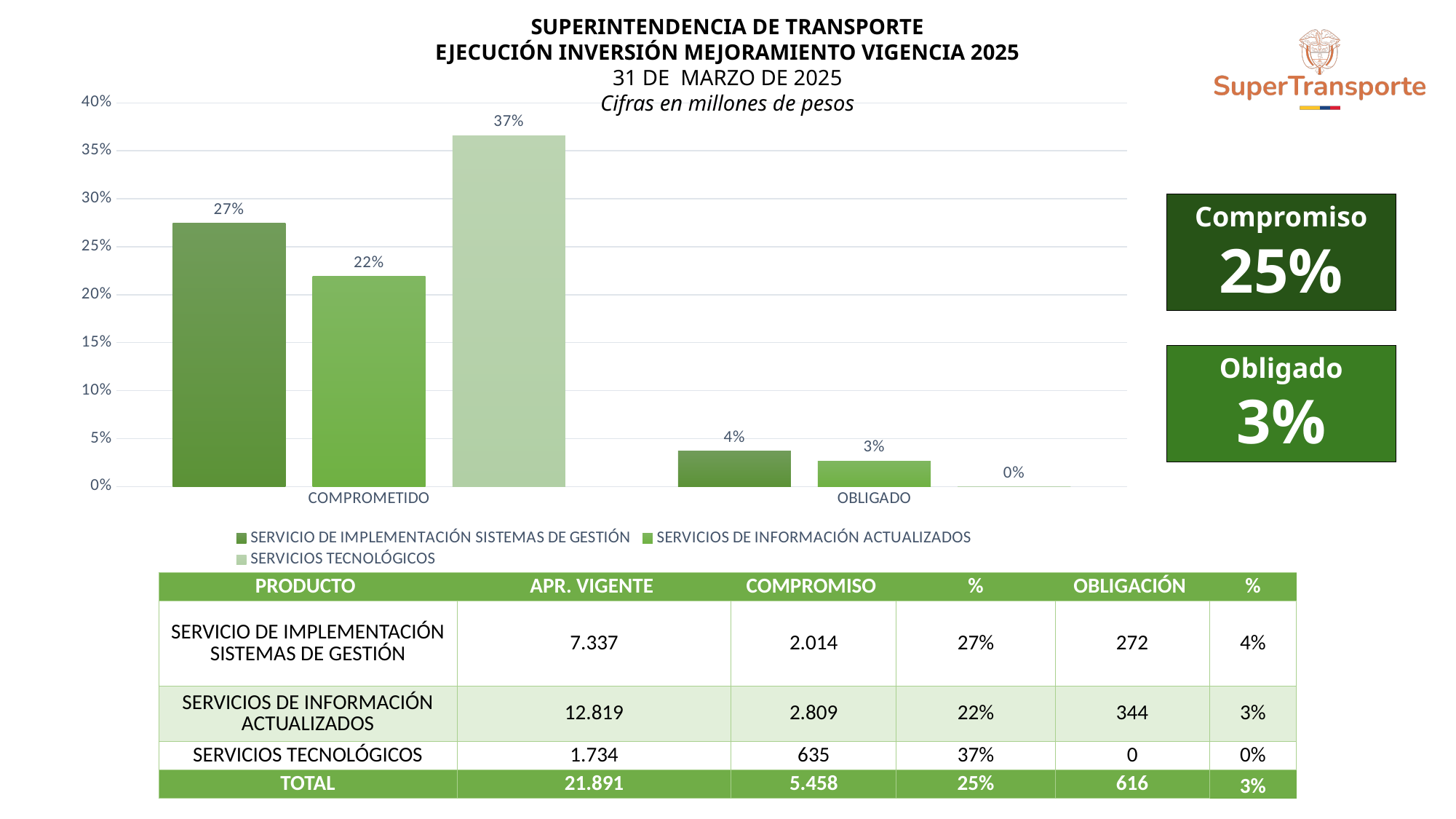
Is the COMPROMETIDO value for SERVICIOS DE INFORMACIÓN ACTUALIZADOS greater or less than 25%? less Which series has the highest COMPROMETIDO value? SERVICIOS TECNOLÓGICOS What is the OBLIGADO value for SERVICIOS DE INFORMACIÓN ACTUALIZADOS? 3% What is the difference between the COMPROMETIDO values for SERVICIOS TECNOLÓGICOS and SERVICIOS DE INFORMACIÓN ACTUALIZADOS? 15% Which series has the lowest OBLIGADO value? SERVICIOS TECNOLÓGICOS What is the COMPROMETIDO value for SERVICIO DE IMPLEMENTACIÓN SISTEMAS DE GESTIÓN? 27% Which is larger: the OBLIGADO value for SERVICIO DE IMPLEMENTACIÓN SISTEMAS DE GESTIÓN or for SERVICIOS DE INFORMACIÓN ACTUALIZADOS? SERVICIO DE IMPLEMENTACIÓN SISTEMAS DE GESTIÓN What kind of chart is shown on the slide? bar chart What is the COMPROMETIDO value for SERVICIOS TECNOLÓGICOS? 37% How many categories are shown on the x axis of the chart? 2 How many series does the chart legend list? 3 What is the OBLIGADO value for SERVICIOS TECNOLÓGICOS? 0%